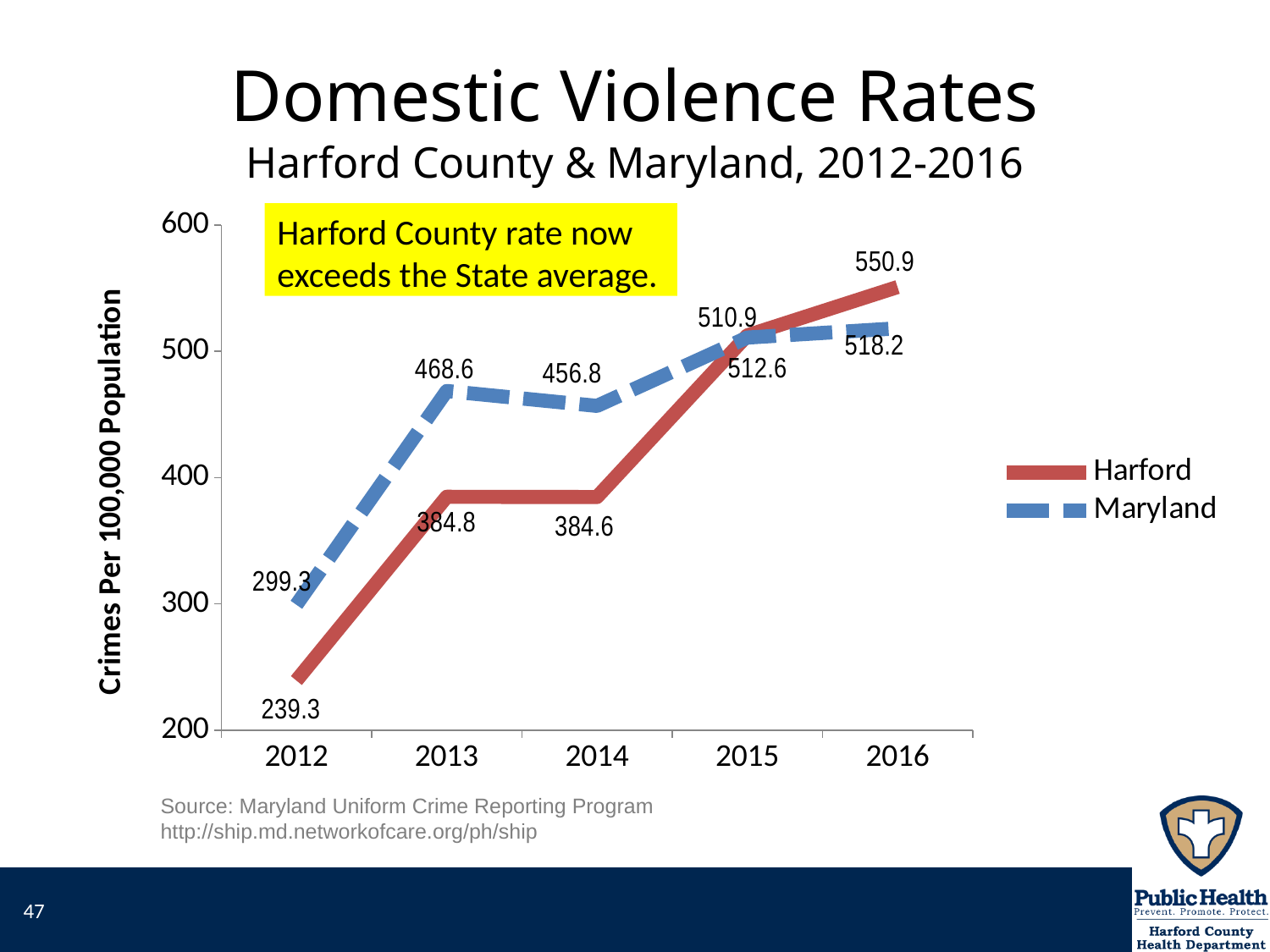
In 2013, which had the higher rate, Harford or Maryland? Maryland What was the Harford domestic violence rate in 2016? 550.9 By how much did the Harford rate exceed the Maryland rate in 2016? 32.7 What is the label on the y axis? Crimes Per 100,000 Population What was the Maryland rate in 2014? 456.8 How many series does the legend list? 2 How many years are plotted on the x axis? 5 What was the Maryland domestic violence rate in 2012? 299.3 In which year was the Harford rate highest? 2016 In which year was the Maryland rate lowest? 2012 What kind of chart is shown on the slide? Line chart What was the Harford rate in 2012? 239.3